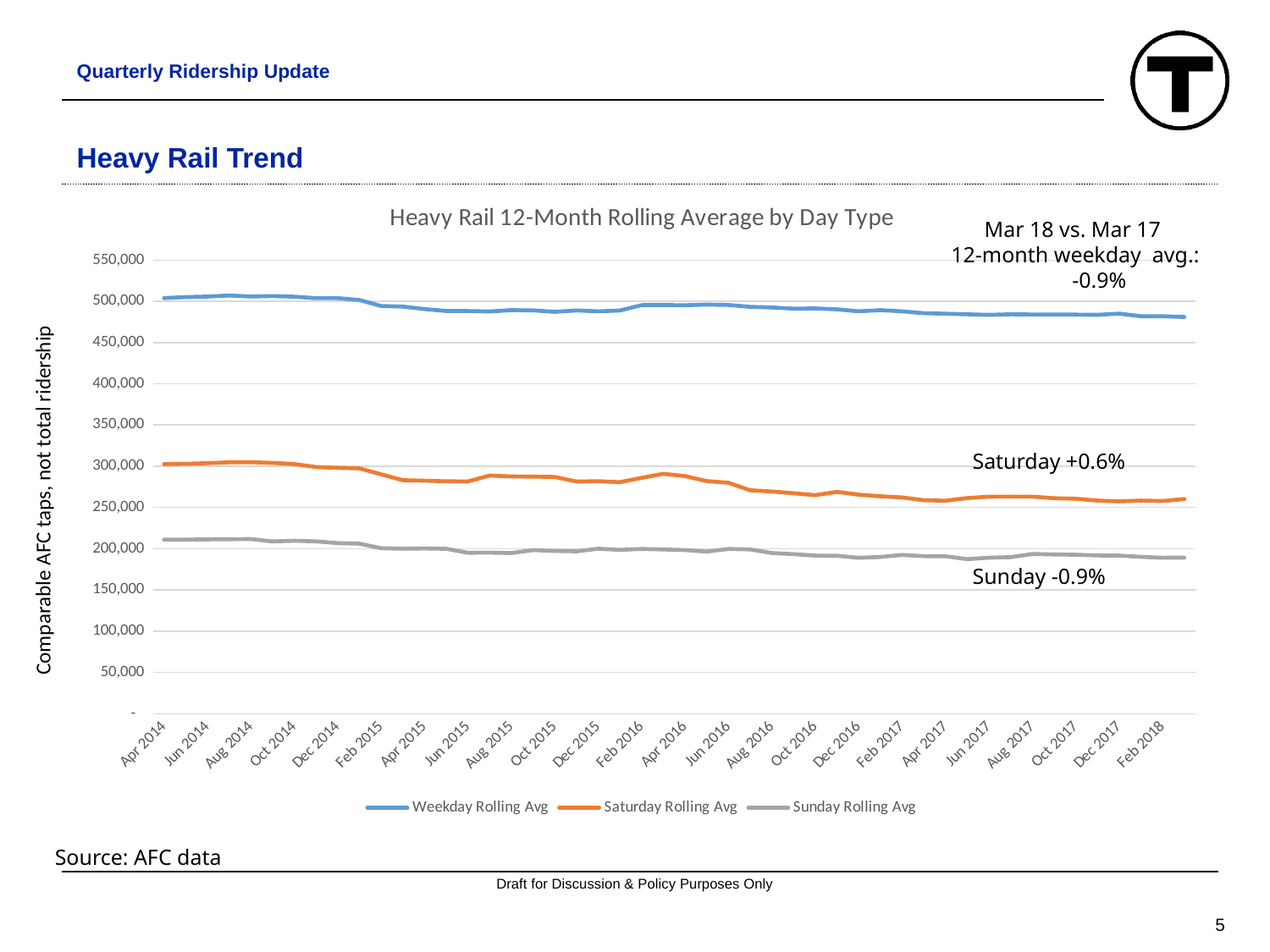
Is the Sunday Rolling Avg value for Apr 2014 greater or less than 250,000? less What is the title of the chart? Heavy Rail 12-Month Rolling Average by Day Type Does the Weekday Rolling Avg generally rise or fall from Apr 2014 to Feb 2018? fall According to the annotation, what is the Mar 18 vs. Mar 17 change in the 12-month Saturday average? +0.6% Which series has the lowest values throughout the chart? Sunday Rolling Avg Is the Saturday Rolling Avg value for Feb 2018 greater or less than 300,000? less How many series does the legend list? 3 Is the Weekday Rolling Avg value for Feb 2018 greater or less than 450,000? greater Which series has the highest values throughout the chart? Weekday Rolling Avg What kind of chart is shown on the slide? line chart Which is larger at Apr 2014, the Weekday Rolling Avg or the Saturday Rolling Avg? Weekday Rolling Avg Which series is plotted in orange? Saturday Rolling Avg